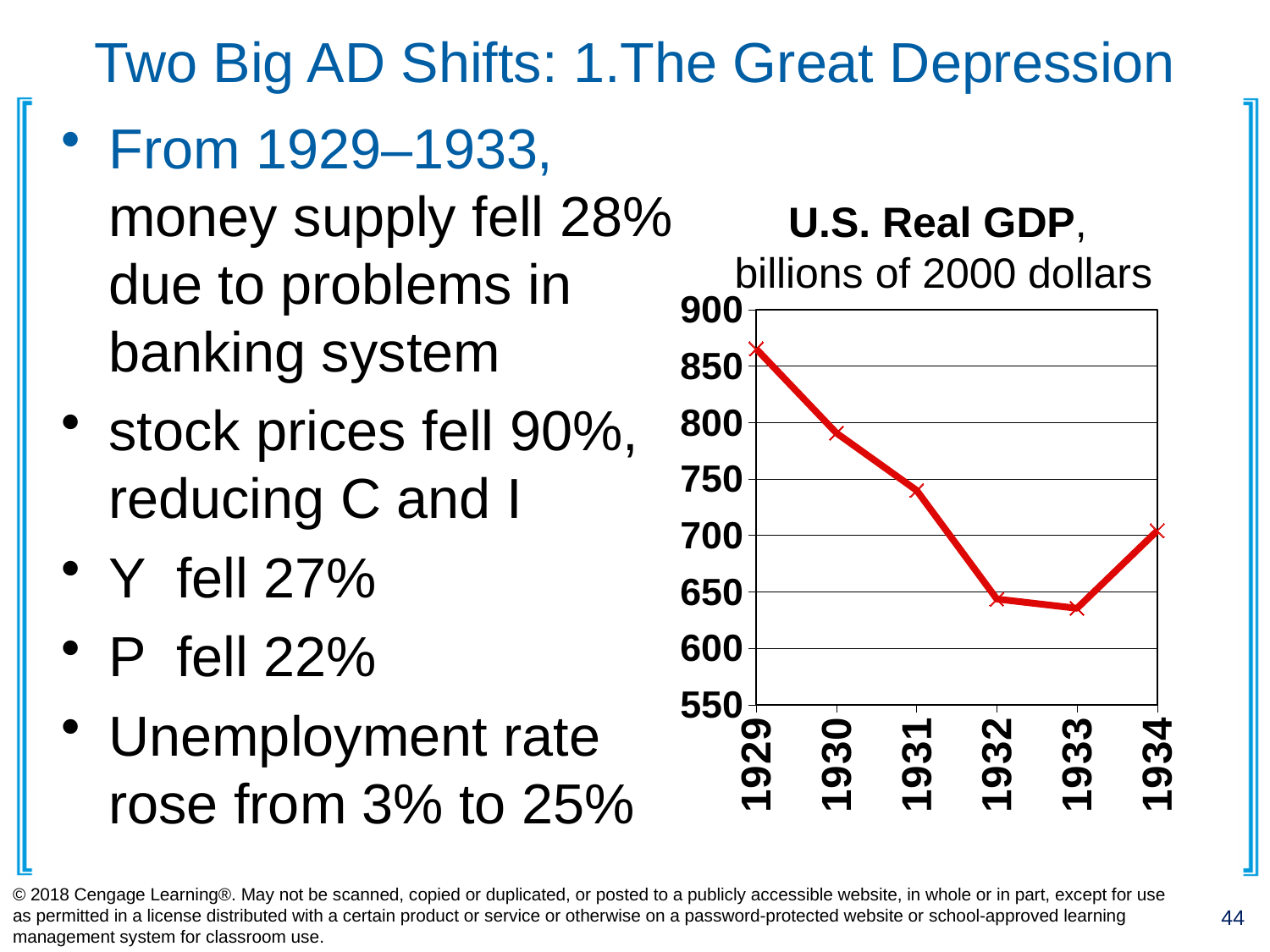
Is the U.S. Real GDP value for 1934 greater or less than 650? greater Is the U.S. Real GDP value for 1932 greater or less than 700? less Which year has the highest U.S. Real GDP on the chart? 1929 Is the U.S. Real GDP value for 1930 greater or less than 750? greater How many years are plotted on the U.S. Real GDP chart? 6 What kind of chart is shown on the slide? line chart Which year has the larger U.S. Real GDP, 1931 or 1933? 1931 In what units is U.S. Real GDP measured on the chart? billions of 2000 dollars How does U.S. Real GDP change from 1929 to 1933 on the chart? It falls Which year has the larger U.S. Real GDP, 1929 or 1934? 1929